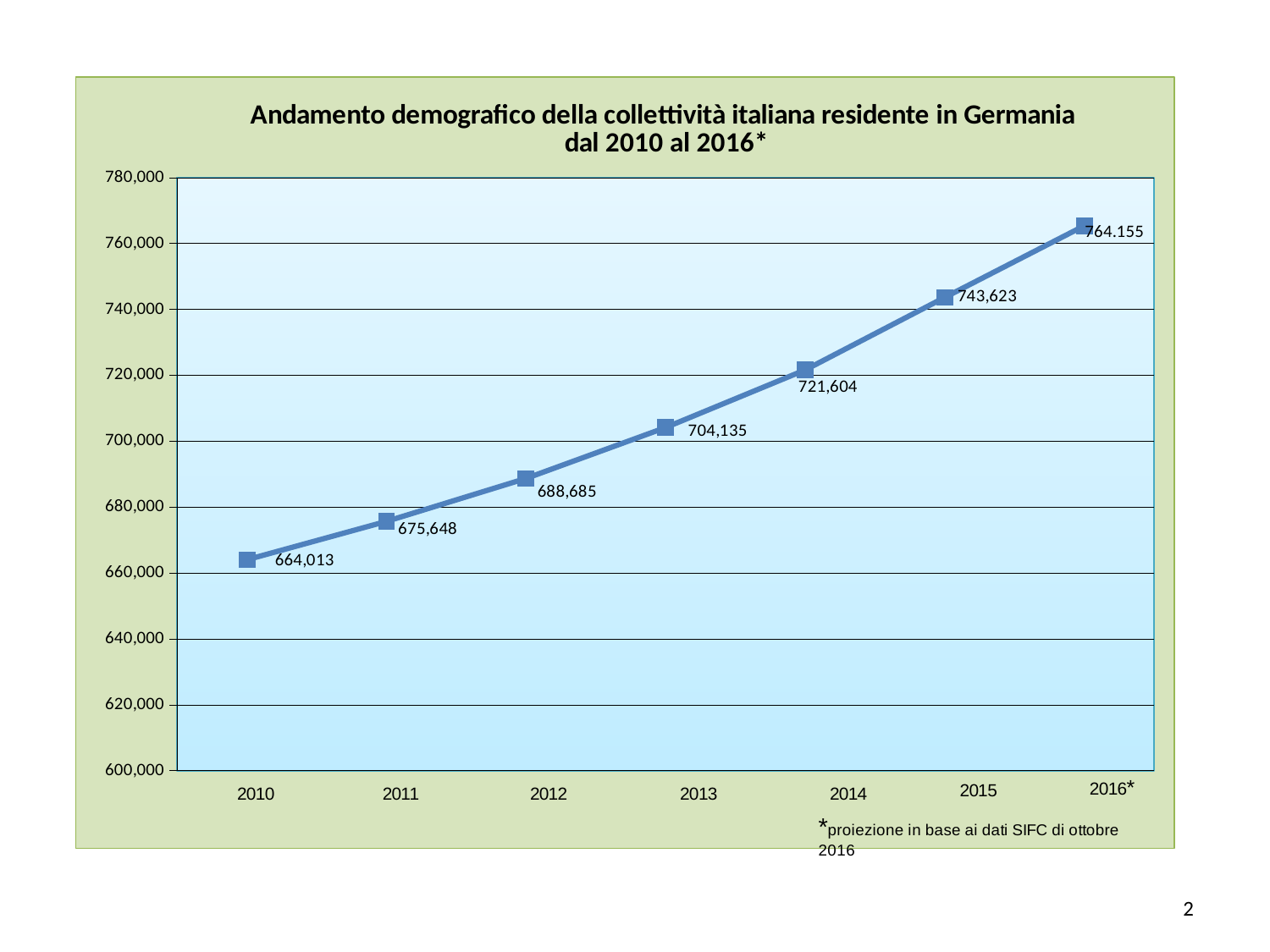
What value is shown for 2010? 664,013 Which is larger, the value for 2012 or the value for 2013? 2013 What is the difference between the values for 2015 and 2014? 22,019 What value is shown for 2015? 743,623 What value is labelled for 2016*? 764.155 What is the difference between the values for 2011 and 2010? 11,635 Which year has the highest value? 2016* Is the value for 2012 greater or less than 700,000? less What kind of chart is shown? line chart What value is shown for 2013? 704,135 Which year has the lowest value? 2010 How many data points are plotted on the chart? 7